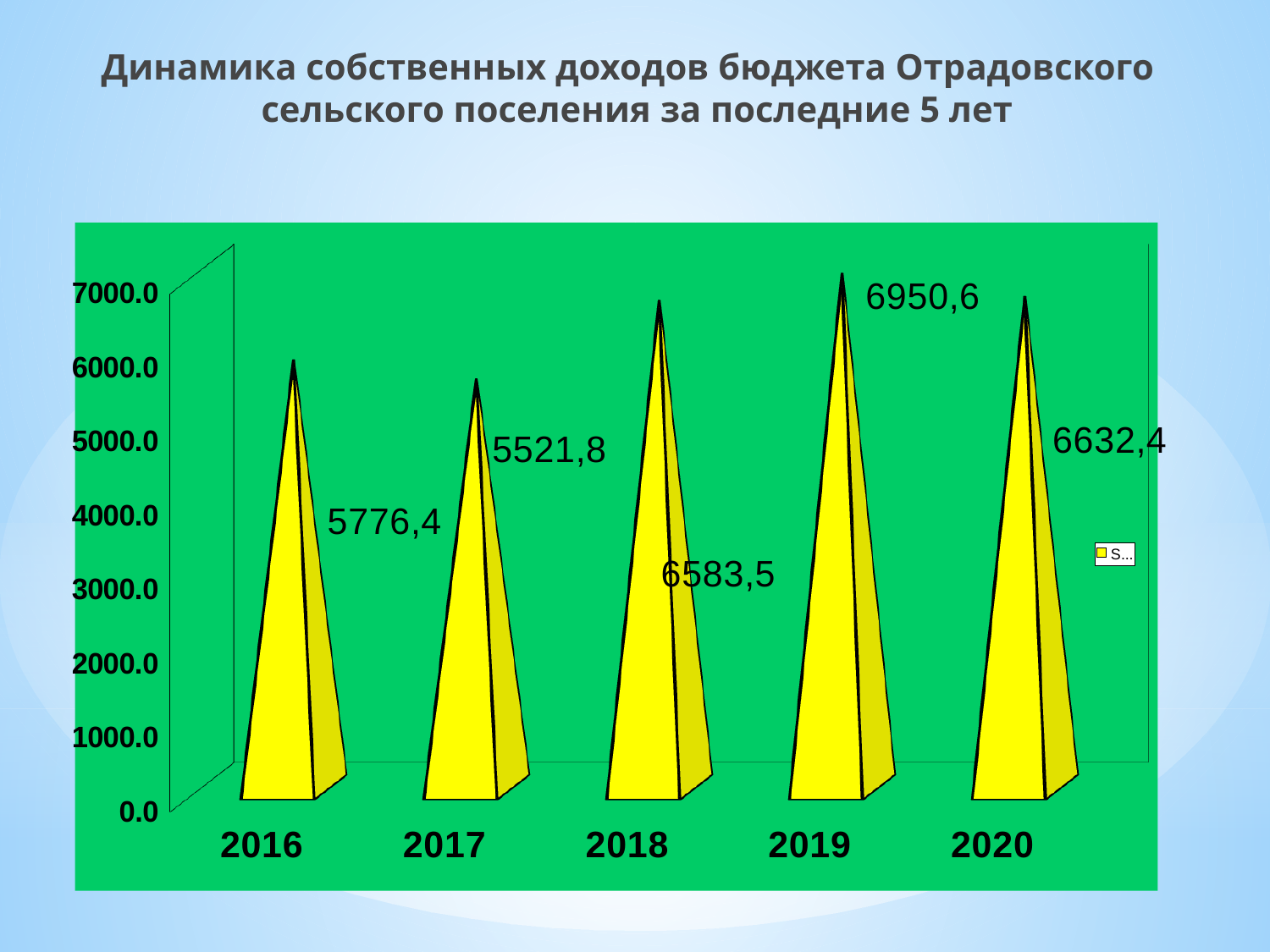
Which is larger, the value for 2018 or the value for 2020? 2020 Is the value for 2017 greater or less than 6000.0? less What is the difference between the values for 2016 and 2017? 254,6 Do the values rise or fall from 2017 to 2019? rise What is the value for 2016? 5776,4 What kind of chart is shown on the slide? bar chart Which year has the lowest value? 2017 What is the value for 2019? 6950,6 What is the value for 2020? 6632,4 How many years are shown on the x axis? 5 Which year has the highest value? 2019 What is the difference between the values for 2019 and 2020? 318,2